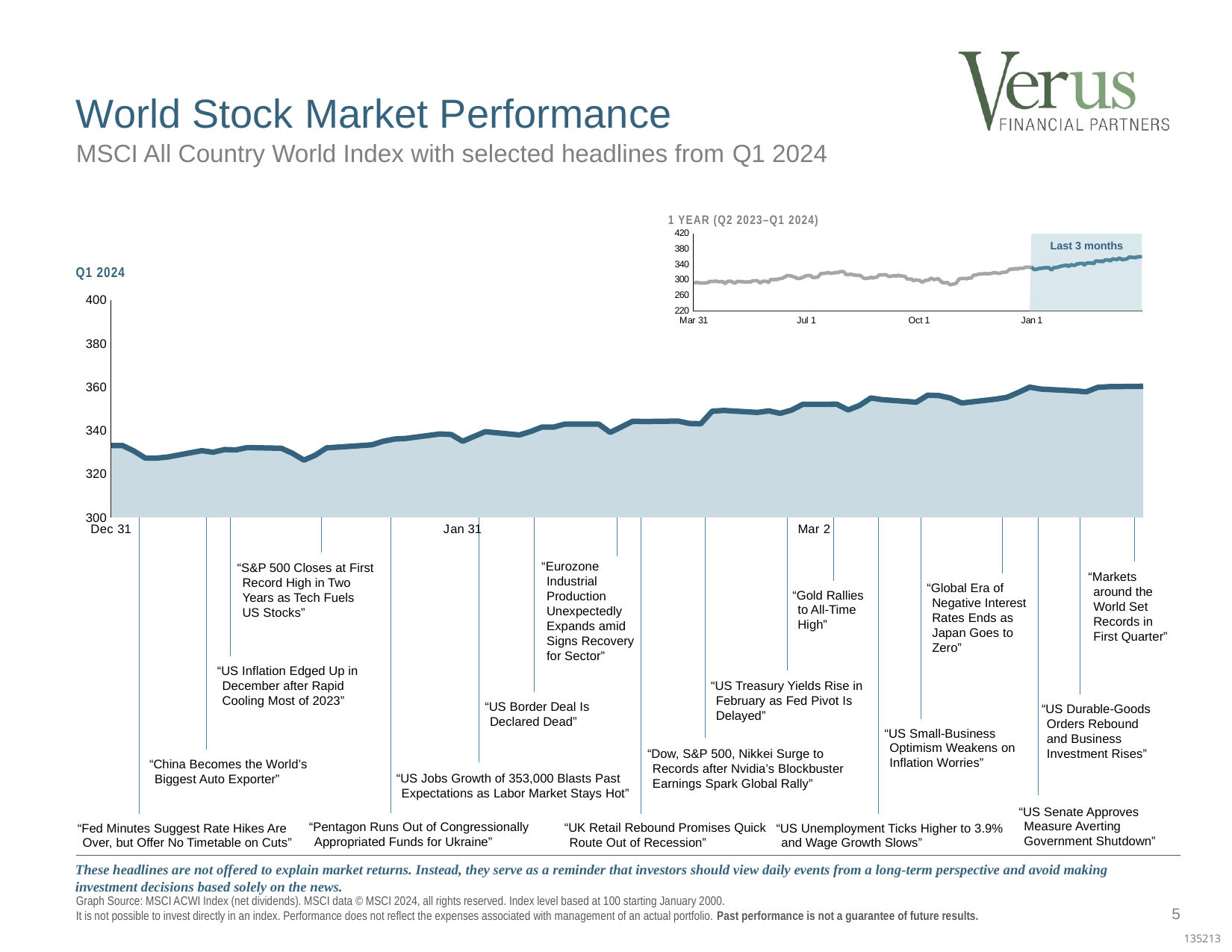
On the Q1 2024 chart, what kind of chart is used to show the index level? area chart On the Q1 2024 chart, is the index value at Dec 31 greater or less than 320? greater How many date labels are shown on the x axis of the 1 YEAR (Q2 2023–Q1 2024) chart? 4 On the Q1 2024 chart, is the index value at Mar 2 greater or less than 340? greater On the 1 YEAR (Q2 2023–Q1 2024) chart, does the index generally rise or fall from Mar 31 to the end of the period? rise What label is shown on the shaded region of the 1 YEAR (Q2 2023–Q1 2024) chart? Last 3 months On the Q1 2024 chart, which is larger: the index value at Dec 31 or the index value at Mar 2? Mar 2 On the 1 YEAR (Q2 2023–Q1 2024) chart, what kind of chart is shown? line chart On the 1 YEAR (Q2 2023–Q1 2024) chart, is the index value at Mar 31 greater or less than 340? less On the Q1 2024 chart, do the index values generally rise or fall from Dec 31 to the end of the quarter? rise